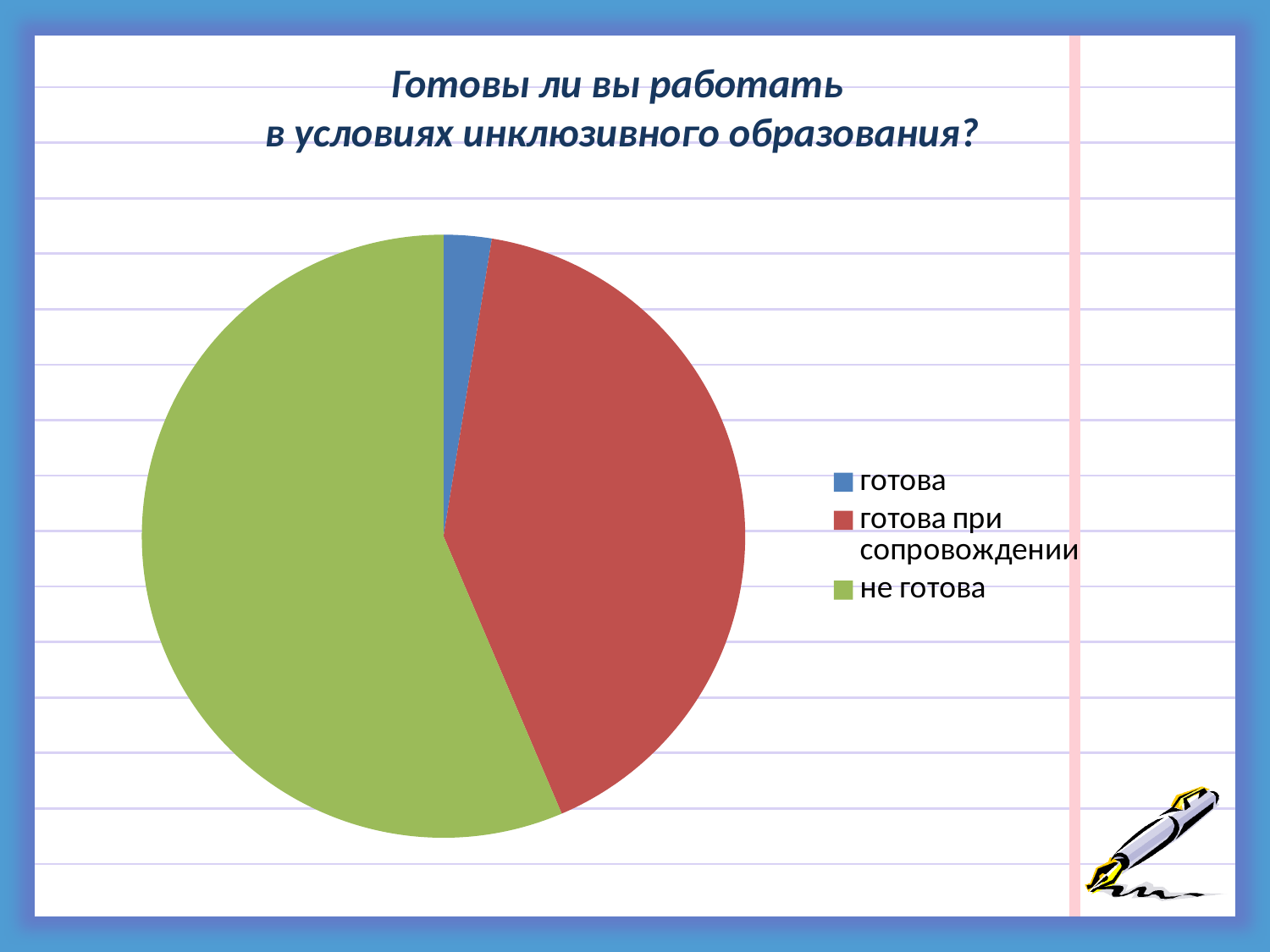
How many slices does the pie chart have? 3 What kind of chart is shown on the slide? pie chart Which category has the smallest slice of the pie chart? готова Which slice is larger: "готова при сопровождении" or "не готова"? не готова What is the title of the chart on the slide? Готовы ли вы работать в условиях инклюзивного образования? Which slice is larger: "готова" or "готова при сопровождении"? готова при сопровождении Which category has the largest slice of the pie chart? не готова What colour is the slice for "не готова" in the pie chart? green How many entries does the legend of the pie chart list? 3